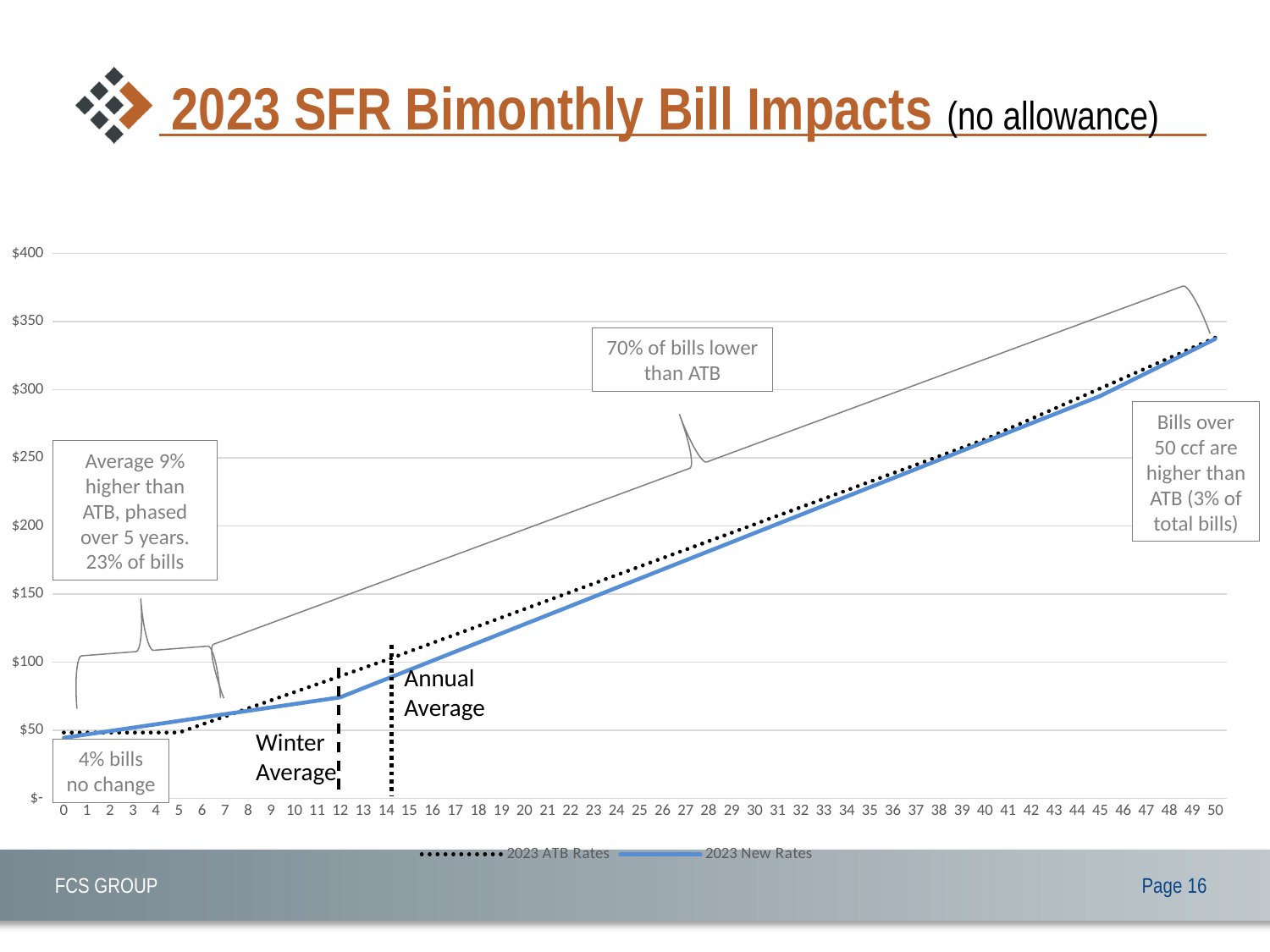
Is the value for 2023 ATB Rates at 25 greater or less than $250? less Is the value for 2023 New Rates at 50 greater or less than $300? greater What kind of chart is shown on the slide? line chart How many series does the legend list? 2 Is the value for 2023 New Rates at 50 greater or less than $350? less What is the highest value shown on the y axis? $400 Do the 2023 New Rates values rise or fall as the x axis increases from 0 to 50? rise What are the two series named in the legend? 2023 ATB Rates and 2023 New Rates What is the title of the chart slide? 2023 SFR Bimonthly Bill Impacts (no allowance) How many points are labelled along the x axis? 51